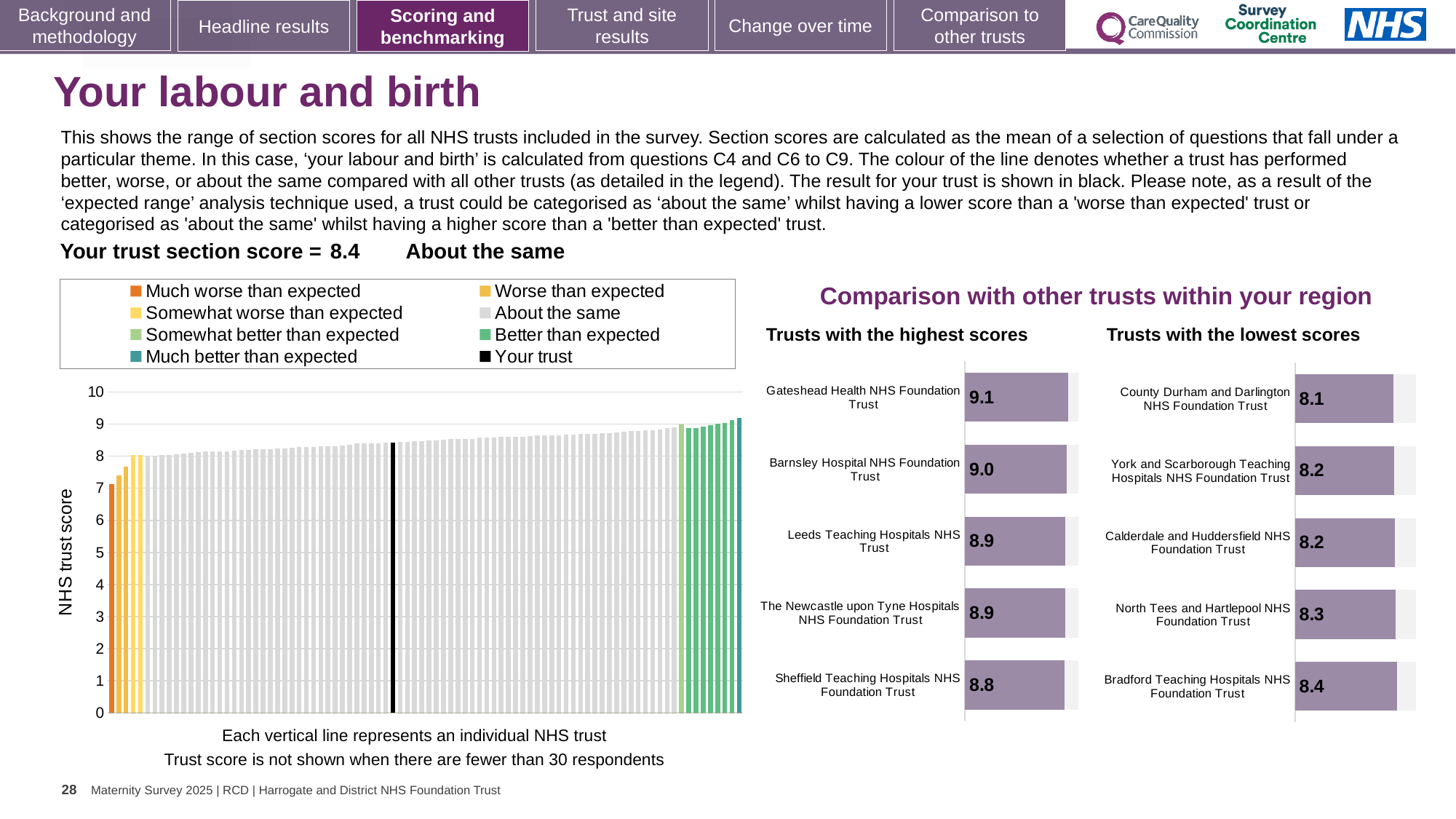
How many entries does the legend of the NHS trust score chart list? 8 How many trusts are shown in the 'Trusts with the lowest scores' chart? 5 In the 'Trusts with the highest scores' chart, what is the score for Gateshead Health NHS Foundation Trust? 9.1 In the 'Trusts with the lowest scores' chart, which trust has the highest score? Bradford Teaching Hospitals NHS Foundation Trust What kind of chart is the NHS trust score chart on the left of the slide? Bar chart In the 'Trusts with the highest scores' chart, which trust has the lowest score? Sheffield Teaching Hospitals NHS Foundation Trust In the 'Trusts with the lowest scores' chart, which has the larger score: North Tees and Hartlepool NHS Foundation Trust or York and Scarborough Teaching Hospitals NHS Foundation Trust? North Tees and Hartlepool NHS Foundation Trust In the 'Trusts with the lowest scores' chart, what is the score for County Durham and Darlington NHS Foundation Trust? 8.1 In the NHS trust score chart on the left, do the bar values rise or fall from left to right? Rise In the 'Trusts with the highest scores' chart, what is the score for Sheffield Teaching Hospitals NHS Foundation Trust? 8.8 In the 'Trusts with the highest scores' chart, what is the difference between the scores of Gateshead Health NHS Foundation Trust and Sheffield Teaching Hospitals NHS Foundation Trust? 0.3 In the NHS trust score chart on the left, is the value of the black 'Your trust' bar greater or less than 8? greater